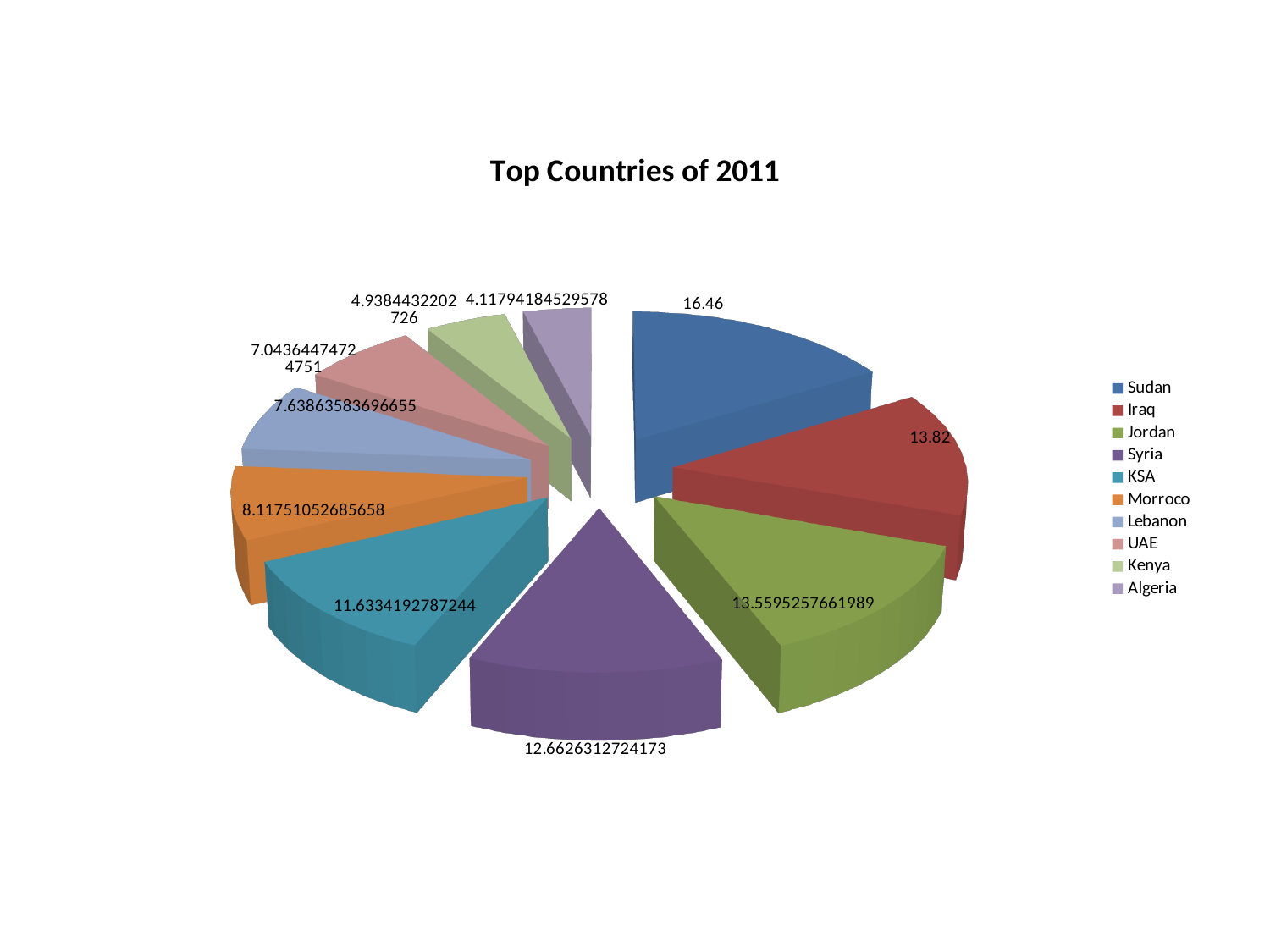
How many slices does the pie chart have? 10 What is the title of the chart? Top Countries of 2011 Which has a larger value, Jordan or Syria? Jordan What type of chart is shown on the slide? Pie chart What is the value shown for Sudan? 16.46 What is the value shown for Morroco? 8.11751052685658 What is the value shown for Iraq? 13.82 Which legend entry is listed last? Algeria What is the value shown for KSA? 11.6334192787244 Which country has the smallest slice of the pie? Algeria Which country has the largest slice of the pie? Sudan What is the difference between the values for Sudan and Iraq? 2.64